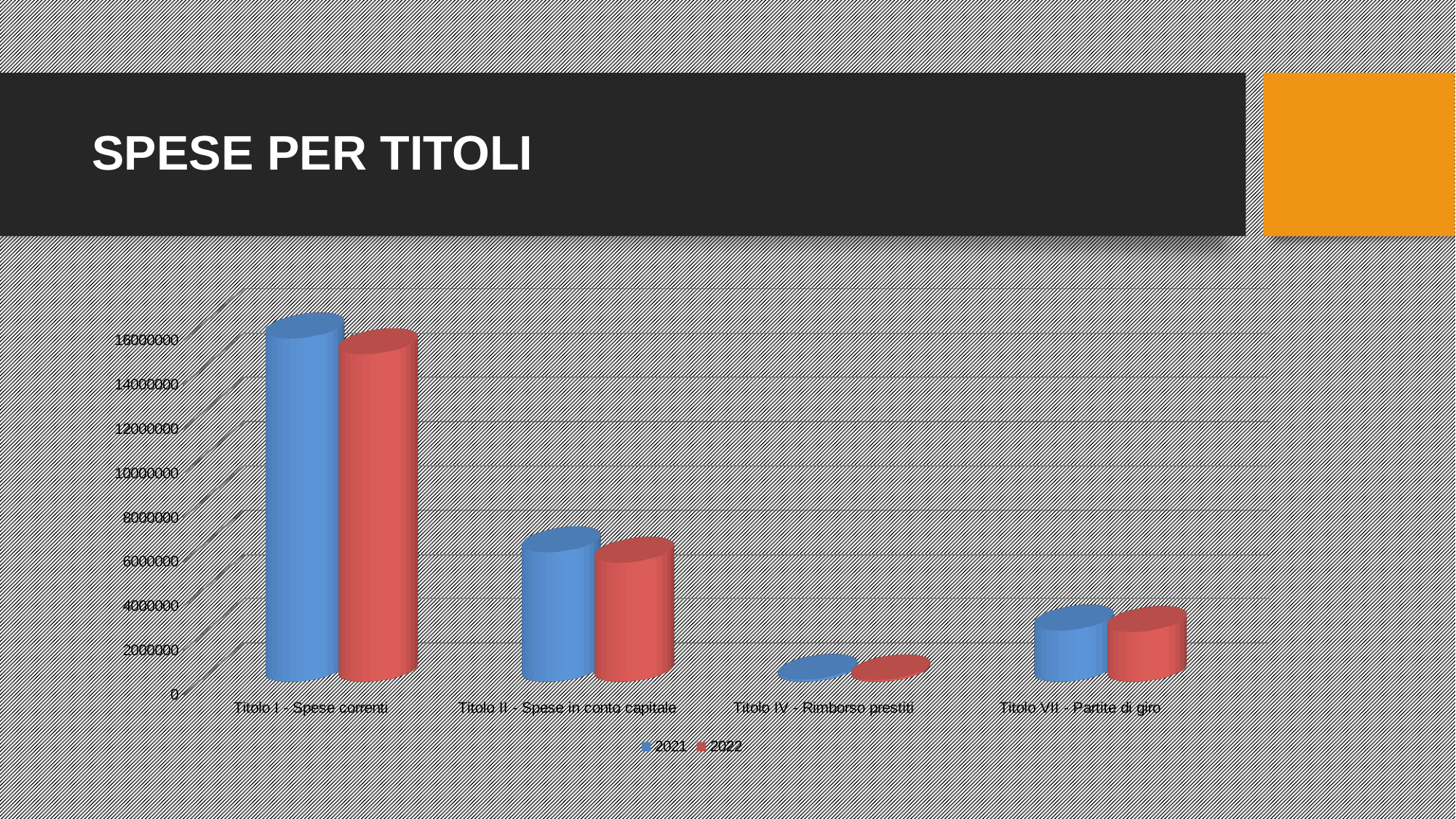
Is the 2022 value for Titolo II - Spese in conto capitale greater or less than 4000000? greater Which category has the lowest value for 2022? Titolo IV - Rimborso prestiti Is the 2021 value for Titolo I - Spese correnti greater or less than 14000000? greater Which colour represents the 2022 series in the chart? red For Titolo I - Spese correnti, which series is larger, 2021 or 2022? 2021 Which category has the highest value for 2021? Titolo I - Spese correnti What is the title of the chart on the slide? SPESE PER TITOLI What kind of chart is shown on the slide? bar chart For Titolo II - Spese in conto capitale, which series is larger, 2021 or 2022? 2021 Is the 2021 value for Titolo IV - Rimborso prestiti greater or less than 2000000? less How many categories are shown on the x axis of the chart? 4 How many series does the chart's legend list? 2